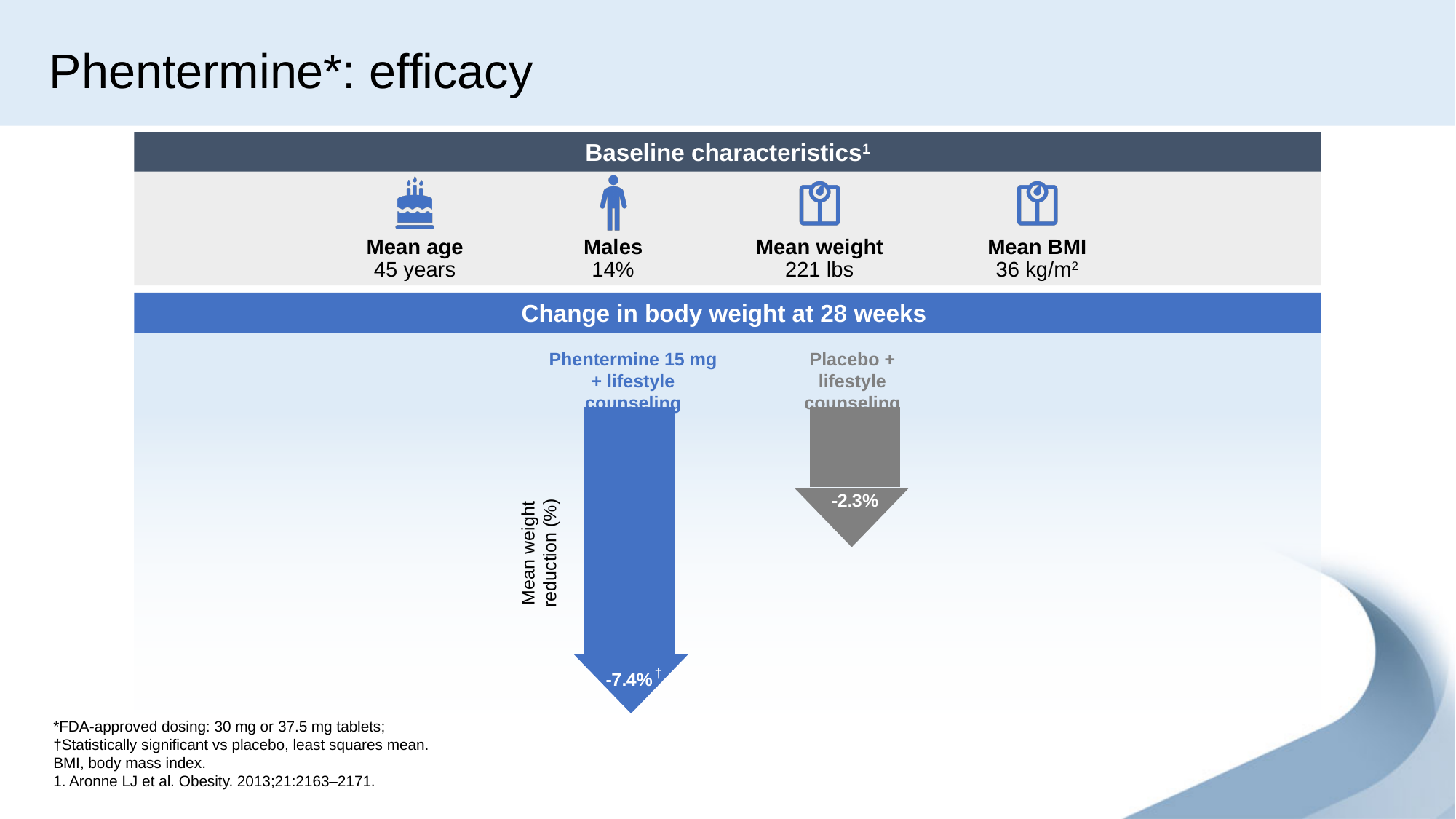
What is the mean weight reduction shown for Phentermine 15 mg + lifestyle counseling? -7.4% Which group shows the larger mean weight reduction? Phentermine 15 mg + lifestyle counseling What is the label on the vertical axis of the weight reduction chart? Mean weight reduction (%) By how many percentage points does the weight reduction for Phentermine 15 mg + lifestyle counseling exceed that for Placebo + lifestyle counseling? 5.1 percentage points Is the weight reduction larger for Phentermine 15 mg + lifestyle counseling or for Placebo + lifestyle counseling? Phentermine 15 mg + lifestyle counseling Which group shows the smaller mean weight reduction? Placebo + lifestyle counseling Which group's weight reduction value is marked with a dagger (†) symbol? Phentermine 15 mg + lifestyle counseling What is the mean weight reduction shown for Placebo + lifestyle counseling? -2.3% What is the title of the chart section showing the weight reduction arrows? Change in body weight at 28 weeks How many treatment groups are shown in the change in body weight chart? 2